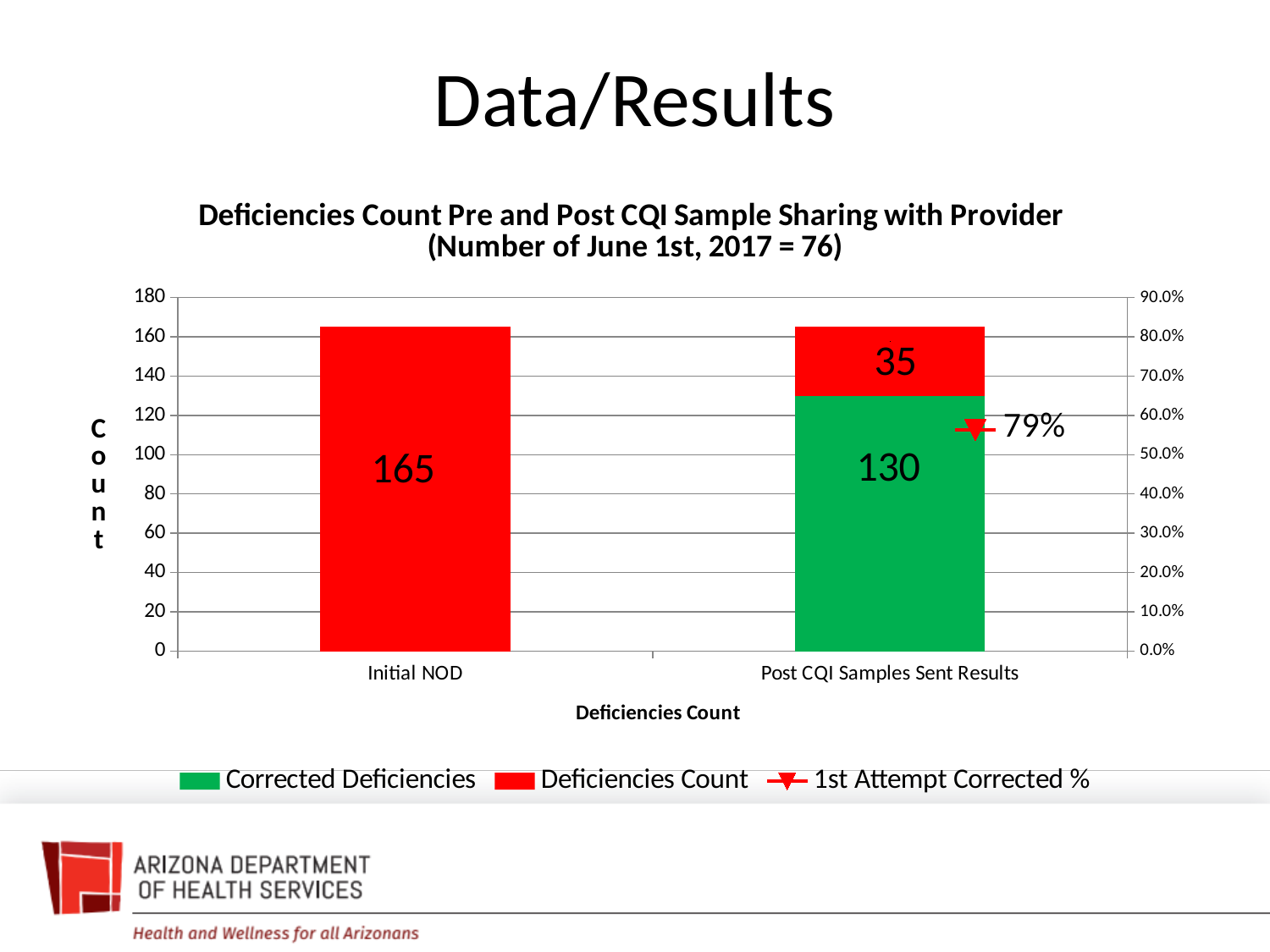
What is the 1st Attempt Corrected % value shown for Post CQI Samples Sent Results? 79% Which colour represents Corrected Deficiencies in the legend? Green How many series does the legend list? 3 What is the Deficiencies Count value for Initial NOD? 165 What is the Corrected Deficiencies value for Post CQI Samples Sent Results? 130 Which is larger: the Corrected Deficiencies for Post CQI Samples Sent Results or the Deficiencies Count for Post CQI Samples Sent Results? Corrected Deficiencies What kind of chart is shown on the slide? Stacked bar chart with a line How many categories are shown on the x axis? 2 What is the difference between the Deficiencies Count for Initial NOD and the Deficiencies Count for Post CQI Samples Sent Results? 130 What is the title of the chart? Deficiencies Count Pre and Post CQI Sample Sharing with Provider (Number of June 1st, 2017 = 76) What is the Deficiencies Count value for Post CQI Samples Sent Results? 35 What is the total of the stacked bar for Post CQI Samples Sent Results? 165